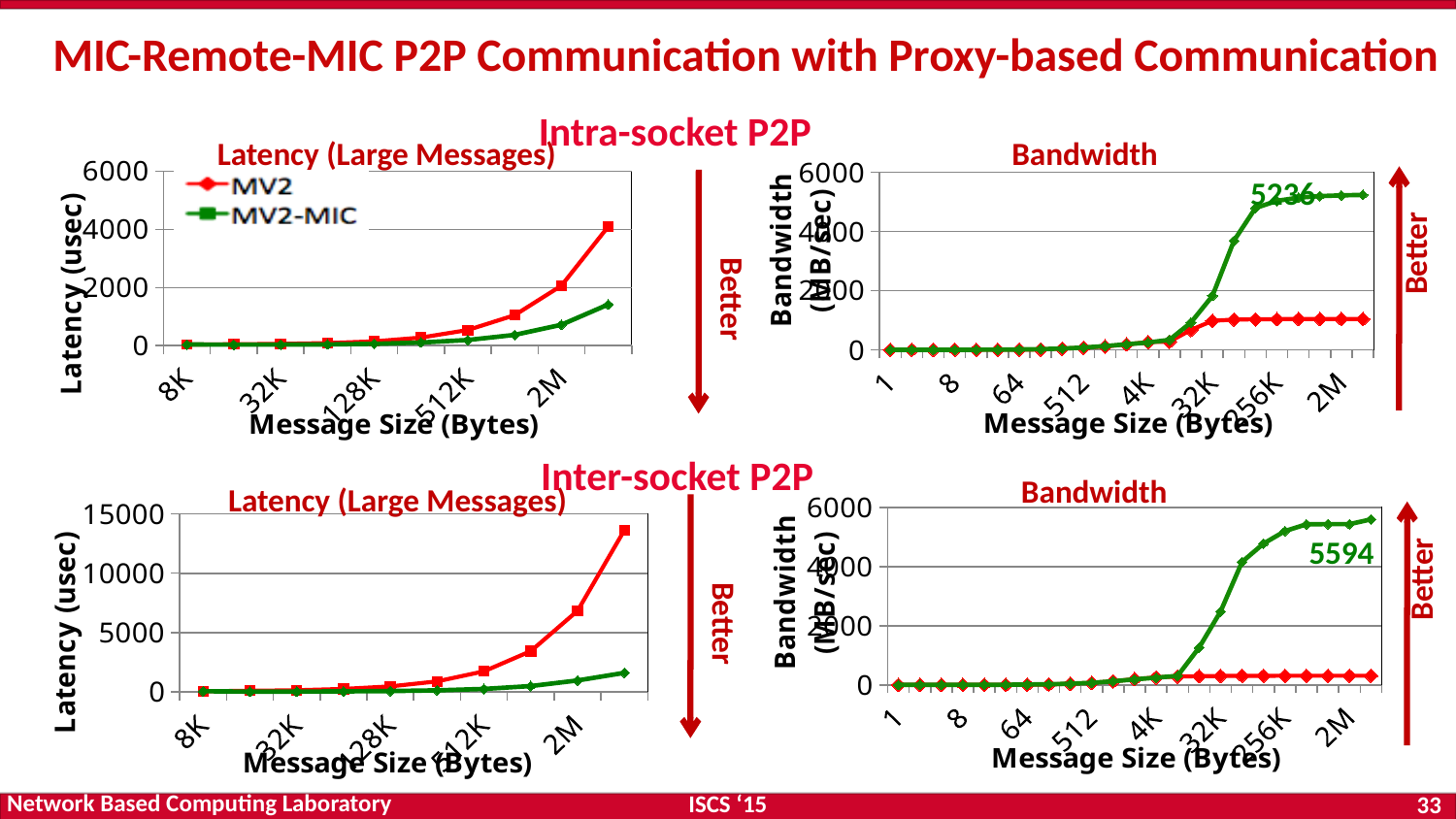
On the Intra-socket P2P Latency (Large Messages) chart, is the MV2 latency at the largest message size greater or less than 2000? greater What colour is the MV2-MIC line in the Intra-socket P2P Latency (Large Messages) chart? green On the Inter-socket P2P Latency (Large Messages) chart, is the MV2 latency at the largest message size greater or less than 10000? greater On the Intra-socket P2P Latency (Large Messages) chart, does the MV2 latency rise or fall as message size increases? rise On the Inter-socket P2P Bandwidth chart, which series reaches the higher bandwidth at 2M, MV2 or MV2-MIC? MV2-MIC On the Intra-socket P2P Latency (Large Messages) chart, which series has the higher latency at the largest message size, MV2 or MV2-MIC? MV2 On the Inter-socket P2P Bandwidth chart, what peak bandwidth value is labelled for MV2-MIC? 5594 On the Inter-socket P2P Bandwidth chart, is the MV2 bandwidth at 2M greater or less than 2000? less On the Intra-socket P2P Bandwidth chart, what peak bandwidth value is labelled for MV2-MIC? 5236 How many series does the legend on the Intra-socket P2P Latency (Large Messages) chart list? 2 What kind of chart is the Intra-socket P2P Latency (Large Messages) chart? line chart